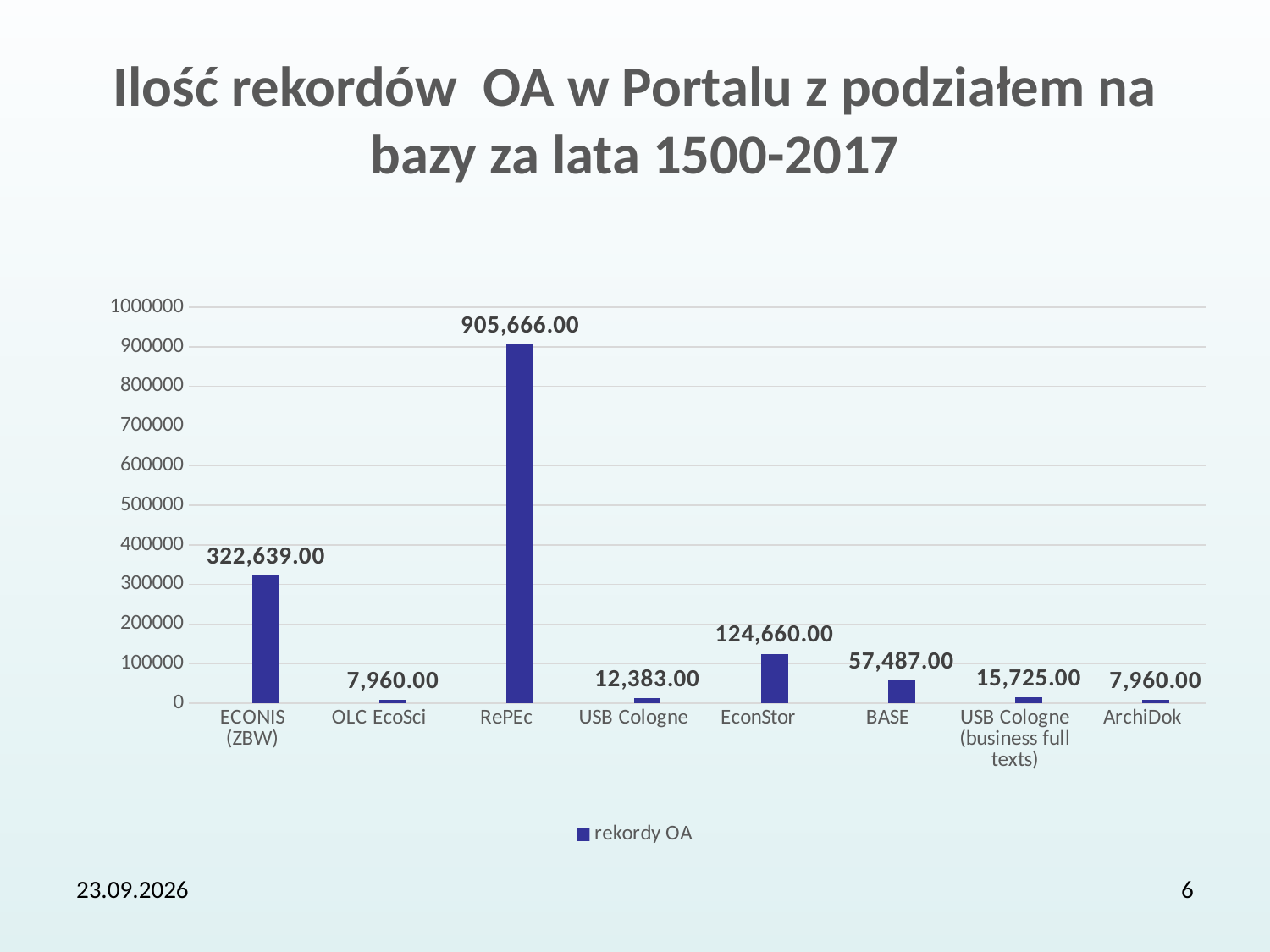
What kind of chart is shown on the slide? bar chart What is the value for RePEc? 905,666.00 Which is larger, the value for EconStor or the value for BASE? EconStor Is the value for ECONIS (ZBW) greater or less than 300000? greater What is the difference between the values for EconStor and BASE? 67,173.00 What is the difference between the values for RePEc and ECONIS (ZBW)? 583,027.00 What is the value for BASE? 57,487.00 How many categories are shown on the x axis? 8 What is the value for USB Cologne (business full texts)? 15,725.00 Which category has the highest value? RePEc What is the value for ECONIS (ZBW)? 322,639.00 How many series does the legend list? 1